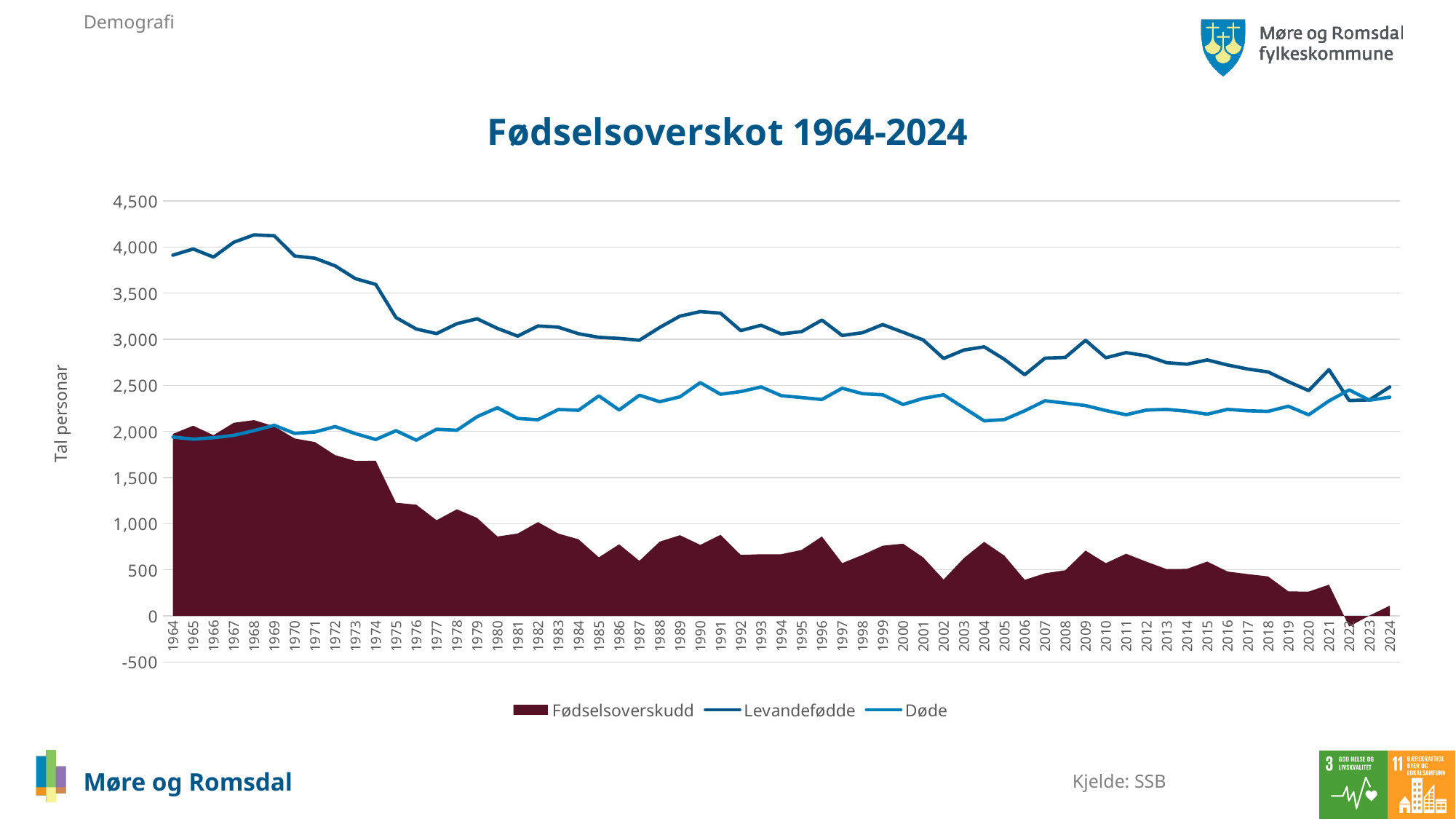
What are the three series named in the legend? Fødselsoverskudd, Levandefødde, Døde In which year is the Fødselsoverskudd value lowest? 2022 How many series does the chart legend list? 3 Does the Fødselsoverskudd series generally rise or fall from 1964 to 2024? fall Is the Levandefødde value for 2024 greater or less than 3,000? less What is the title of the chart? Fødselsoverskot 1964-2024 Is the Døde value for 2004 greater or less than 2,500? less Does the Døde series generally rise or fall from 1964 to 2024? rise Is the Fødselsoverskudd value for 1975 greater or less than 1,500? less Which series has the larger value in 1964, Levandefødde or Døde? Levandefødde